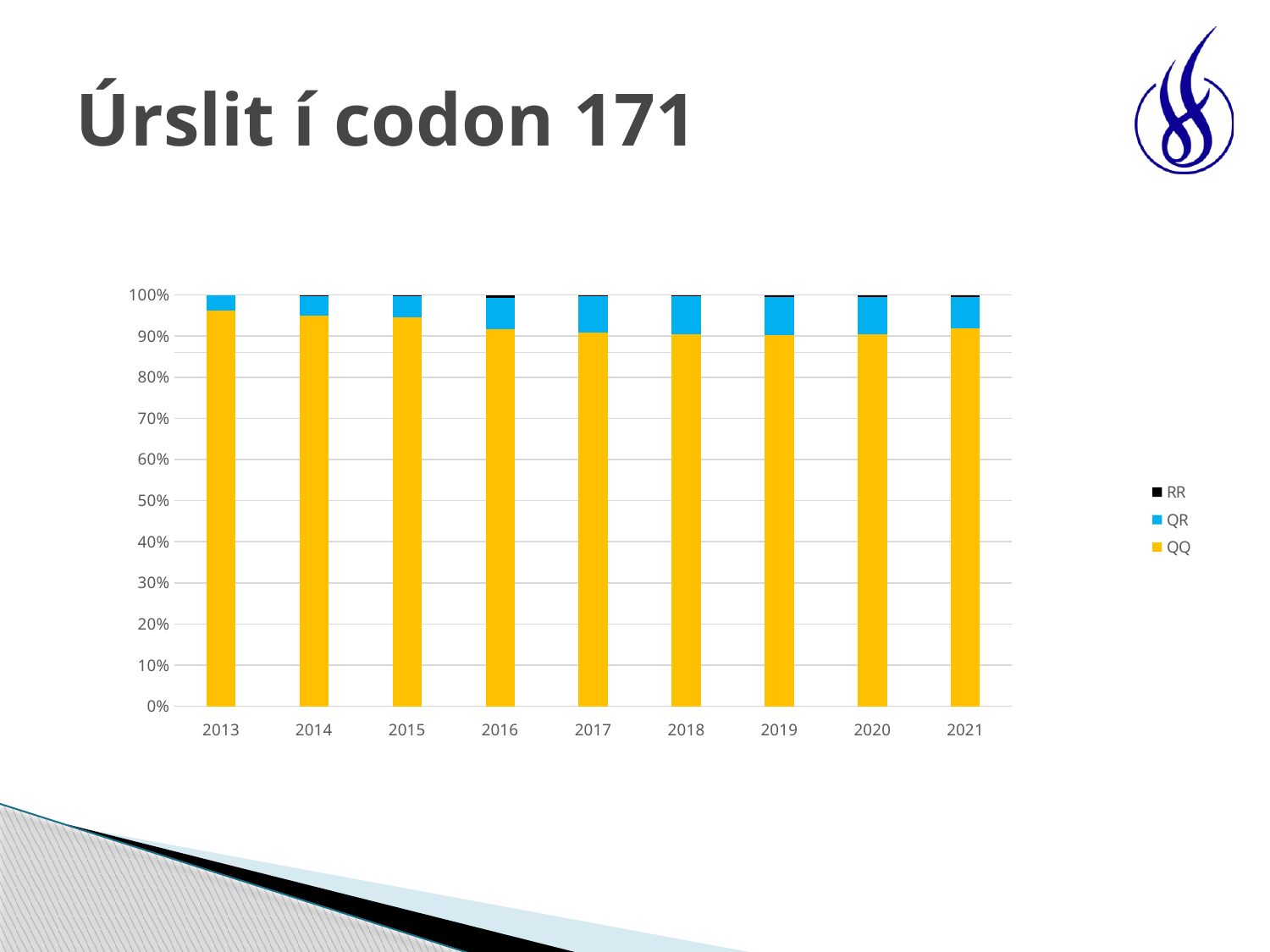
Is the QR share for 2018 greater or less than 20%? less What kind of chart is shown on the slide? stacked bar chart What is the title of the slide containing the chart? Úrslit í codon 171 Which year has the larger QR share, 2013 or 2018? 2018 How many years are shown along the x axis? 9 Does the QQ share rise or fall from 2013 to 2018? fall Is the QQ share for 2019 greater or less than 80%? greater Which series is shown in yellow? QQ Which year has the larger QQ share, 2013 or 2019? 2013 Is the QQ share for 2014 greater or less than 90%? greater How many series does the legend list? 3